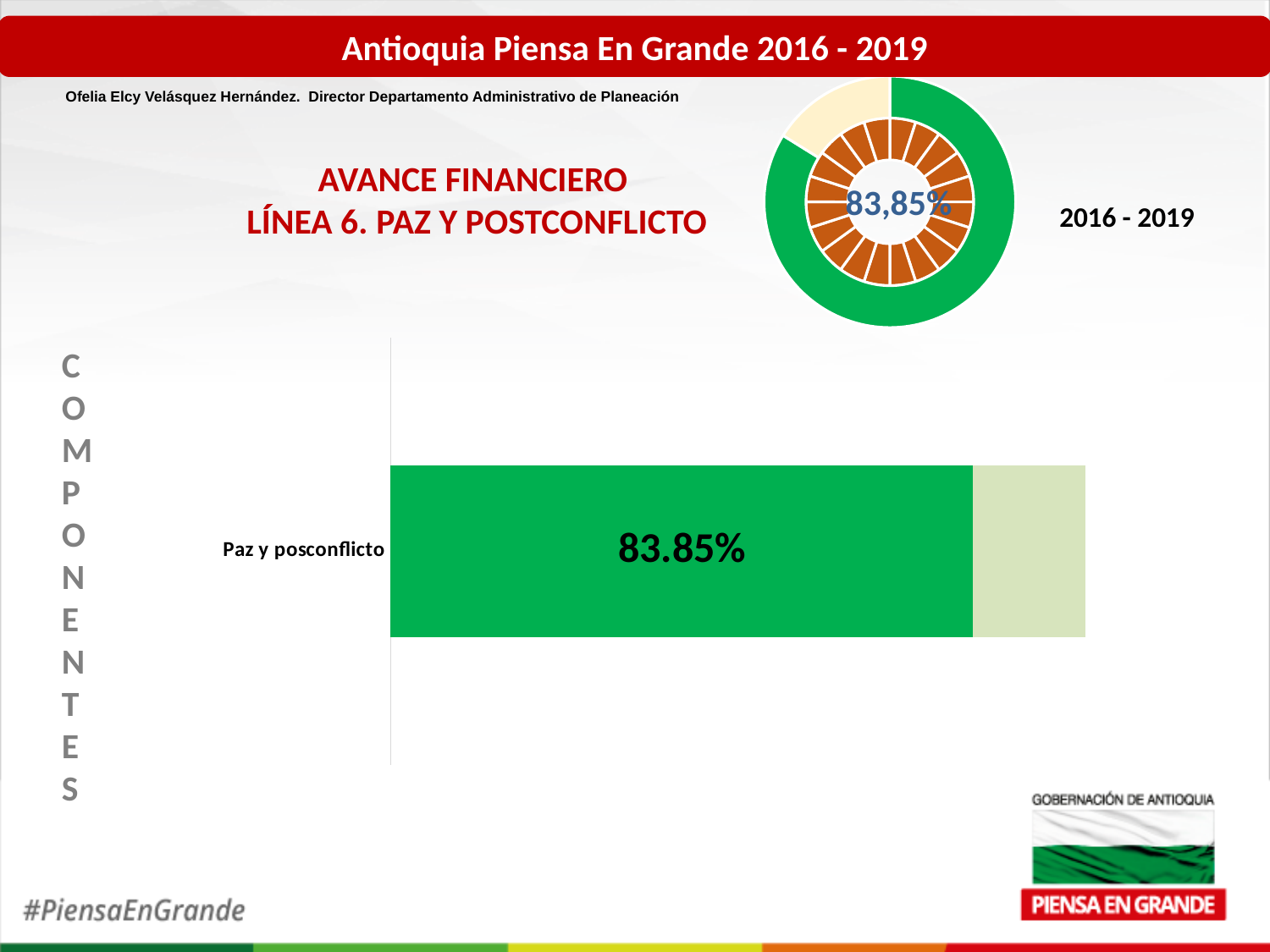
What is the category label shown on the bar chart at the bottom of the slide? Paz y posconflicto What kind of chart is the chart at the bottom of the slide? bar chart What period label is printed to the right of the donut chart at the top of the slide? 2016 - 2019 In the donut chart at the top right of the slide, what percentage is printed in the centre? 83,85% What kind of chart is the chart at the top right of the slide? donut chart How many categories are plotted in the bar chart at the bottom of the slide? 1 In the donut chart at the top right of the slide, what share does the green segment represent? 83,85% In the bar chart at the bottom of the slide, what is the value shown for Paz y posconflicto? 83.85%